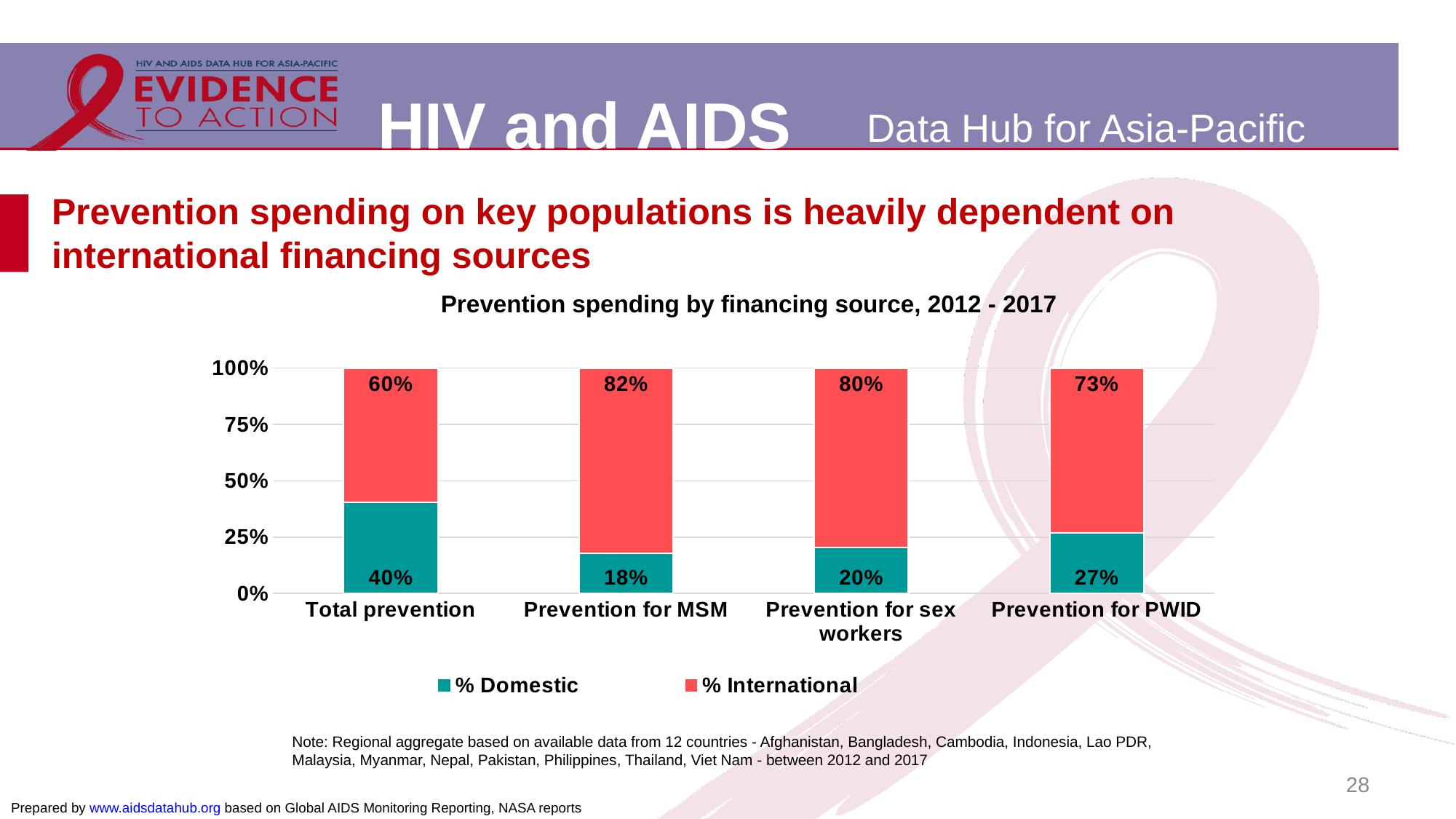
What is the % Domestic value for Total prevention? 40% What is the title of the chart? Prevention spending by financing source, 2012 - 2017 What is the % Domestic value for Prevention for PWID? 27% What is the % International value for Prevention for sex workers? 80% What is the % International value for Prevention for MSM? 82% Which category has the lowest % Domestic value? Prevention for MSM What kind of chart is shown? Stacked bar chart How many categories are shown on the x axis? 4 What is the difference between the % International values for Prevention for MSM and Total prevention? 22% How many series does the legend list? 2 Which category has the highest % International value? Prevention for MSM Which is larger, the % Domestic value for Prevention for sex workers or for Prevention for PWID? Prevention for PWID